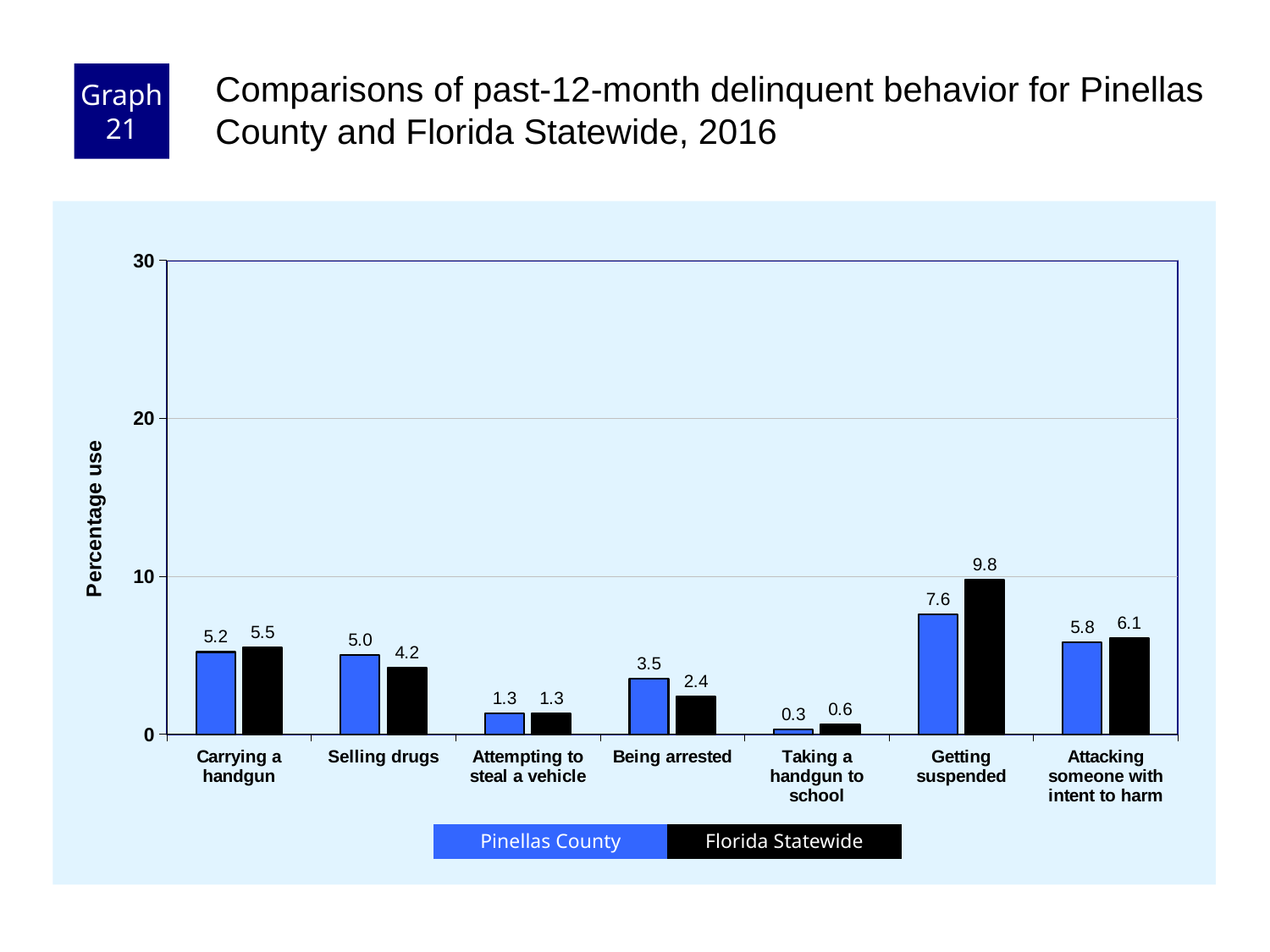
What is the Pinellas County value for Getting suspended? 7.6 Which category has the highest Florida Statewide value? Getting suspended What is the difference between the Pinellas County and Florida Statewide values for Being arrested? 1.1 How many categories are shown on the x axis? 7 What is the Florida Statewide value for Selling drugs? 4.2 What is the Pinellas County value for Taking a handgun to school? 0.3 What is the difference between the Florida Statewide and Pinellas County values for Getting suspended? 2.2 Which is larger for Selling drugs: the Pinellas County value or the Florida Statewide value? Pinellas County What kind of chart is shown on the slide? bar chart How many series does the legend list? 2 Is the Florida Statewide value for Getting suspended greater or less than 10? less Which category has the lowest Pinellas County value? Taking a handgun to school